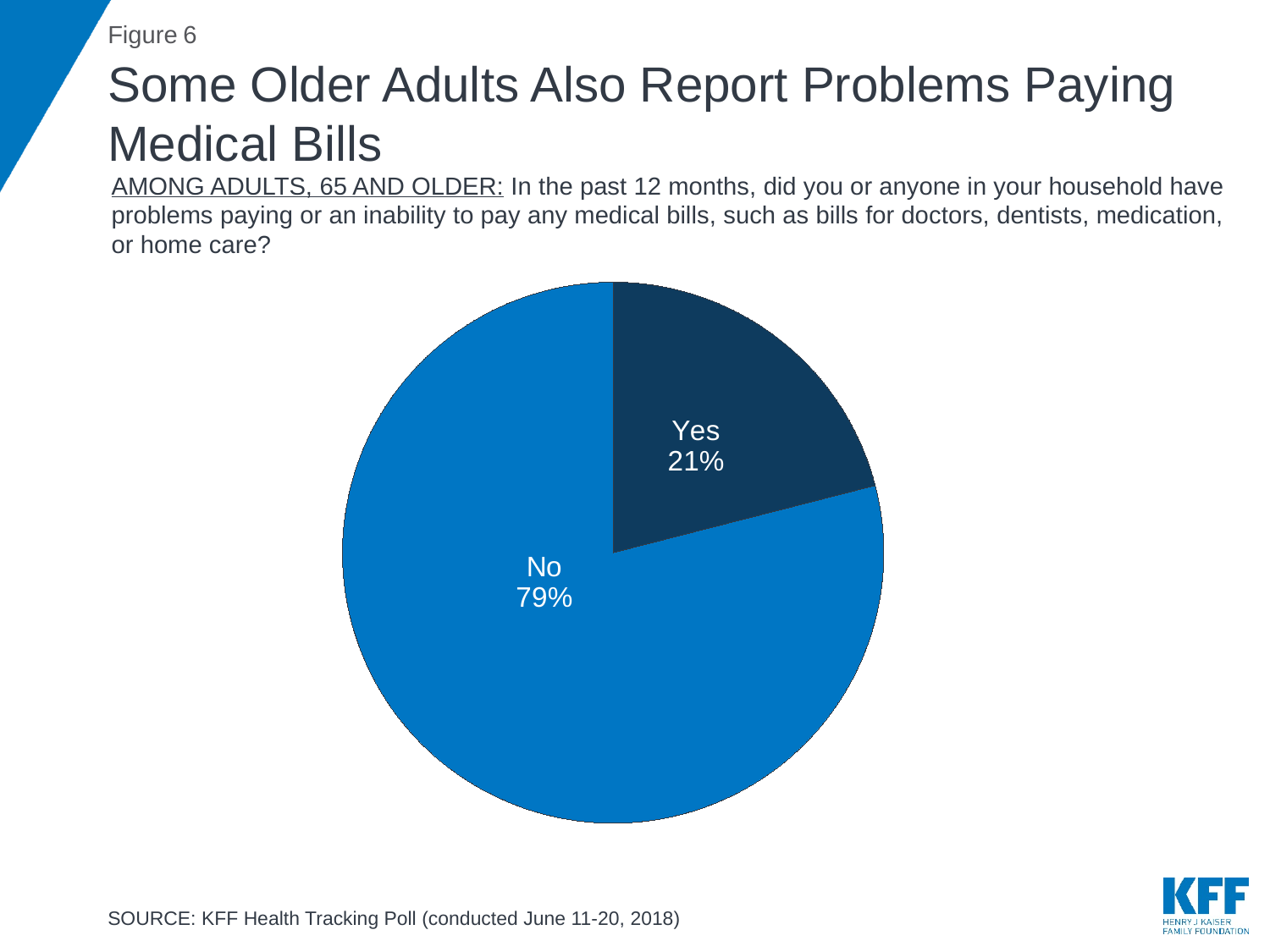
What percentage of adults 65 and older answered "No"? 79% What is the difference in percentage points between the "No" and "Yes" slices? 58 What kind of chart is shown on the slide? pie chart Is the "Yes" slice larger or smaller than the "No" slice? smaller What percentage of adults 65 and older answered "Yes" to having problems paying medical bills? 21% What is the title of the slide containing the chart? Some Older Adults Also Report Problems Paying Medical Bills Which response has the larger share of the pie? No How many slices does the pie chart have? 2 What is the total of the two slices shown in the pie chart? 100% Which response has the smaller share of the pie? Yes What share of the pie does the "Yes" slice represent? 21% Which slice is shown in the darker blue colour? Yes